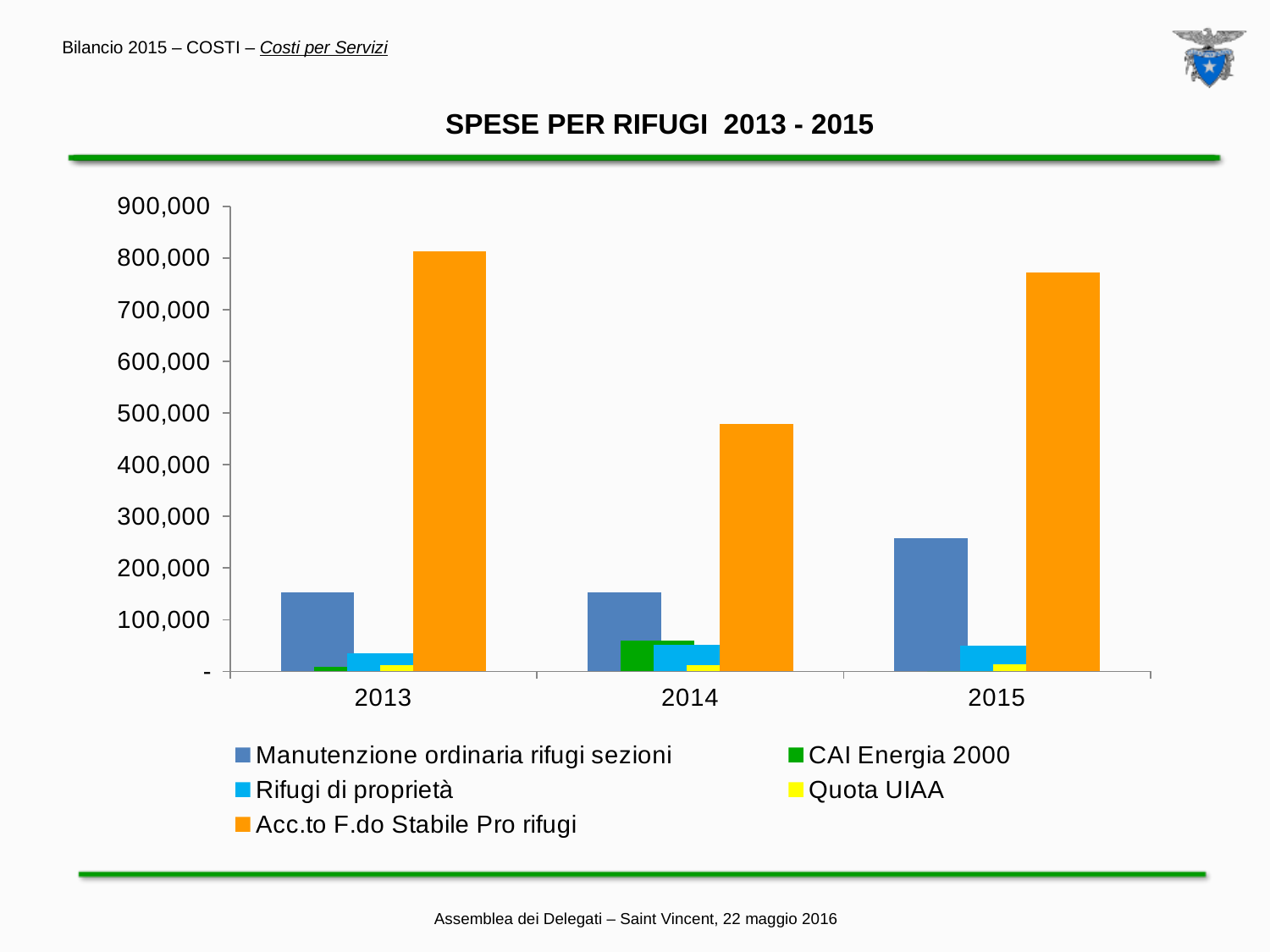
Is the value for Manutenzione ordinaria rifugi sezioni in 2015 greater or less than 200,000? greater Is the value for Acc.to F.do Stabile Pro rifugi in 2014 greater or less than 500,000? less In which year is the value for Acc.to F.do Stabile Pro rifugi highest? 2013 Which series has the highest value in 2015? Acc.to F.do Stabile Pro rifugi In 2014, which is larger: Acc.to F.do Stabile Pro rifugi or Manutenzione ordinaria rifugi sezioni? Acc.to F.do Stabile Pro rifugi Is the value for Acc.to F.do Stabile Pro rifugi in 2013 greater or less than 700,000? greater In which year is the value for Acc.to F.do Stabile Pro rifugi lowest? 2014 How many series does the legend list? 5 What kind of chart is shown on the slide? bar chart Which is larger: Manutenzione ordinaria rifugi sezioni in 2015 or in 2013? 2015 What is the title of the chart? SPESE PER RIFUGI 2013 - 2015 How many years are shown on the x axis? 3